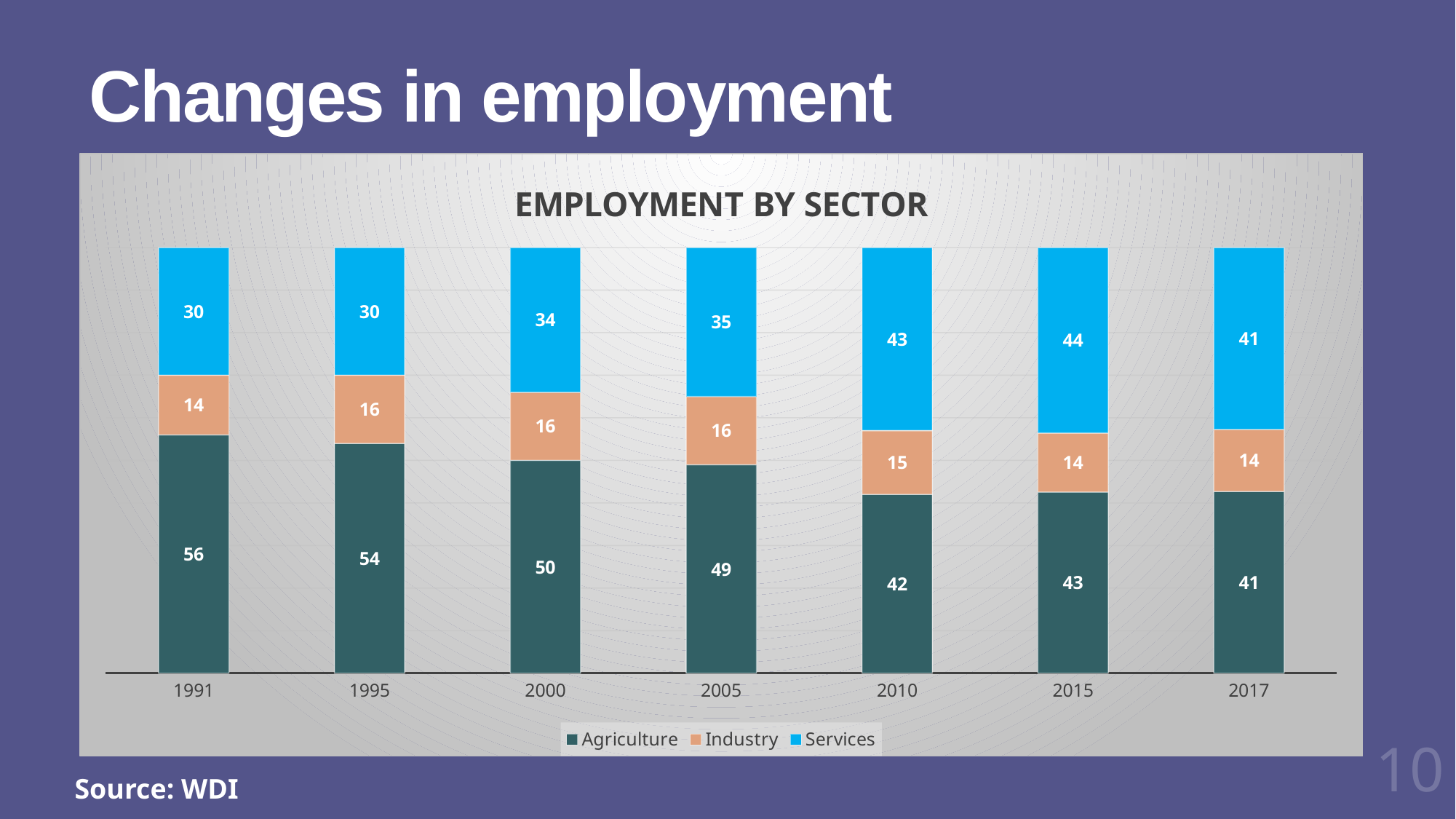
How many years are shown on the x axis? 7 What is the Agriculture value for 1991 in the Employment by Sector chart? 56 What kind of chart is shown on the slide? Stacked bar chart In which year is the Services value lowest? 1991 and 1995 What is the difference between the Agriculture value in 1991 and in 2017? 15 Does the Agriculture value generally rise or fall from 1991 to 2017? Fall What is the Services value for 2015? 44 Which is larger in 2010, the Agriculture value or the Services value? Services What is the total of the stacked bar for 1991? 100 In which year is the Agriculture value highest? 1991 How many series does the legend list? 3 What is the Industry value for 2005? 16